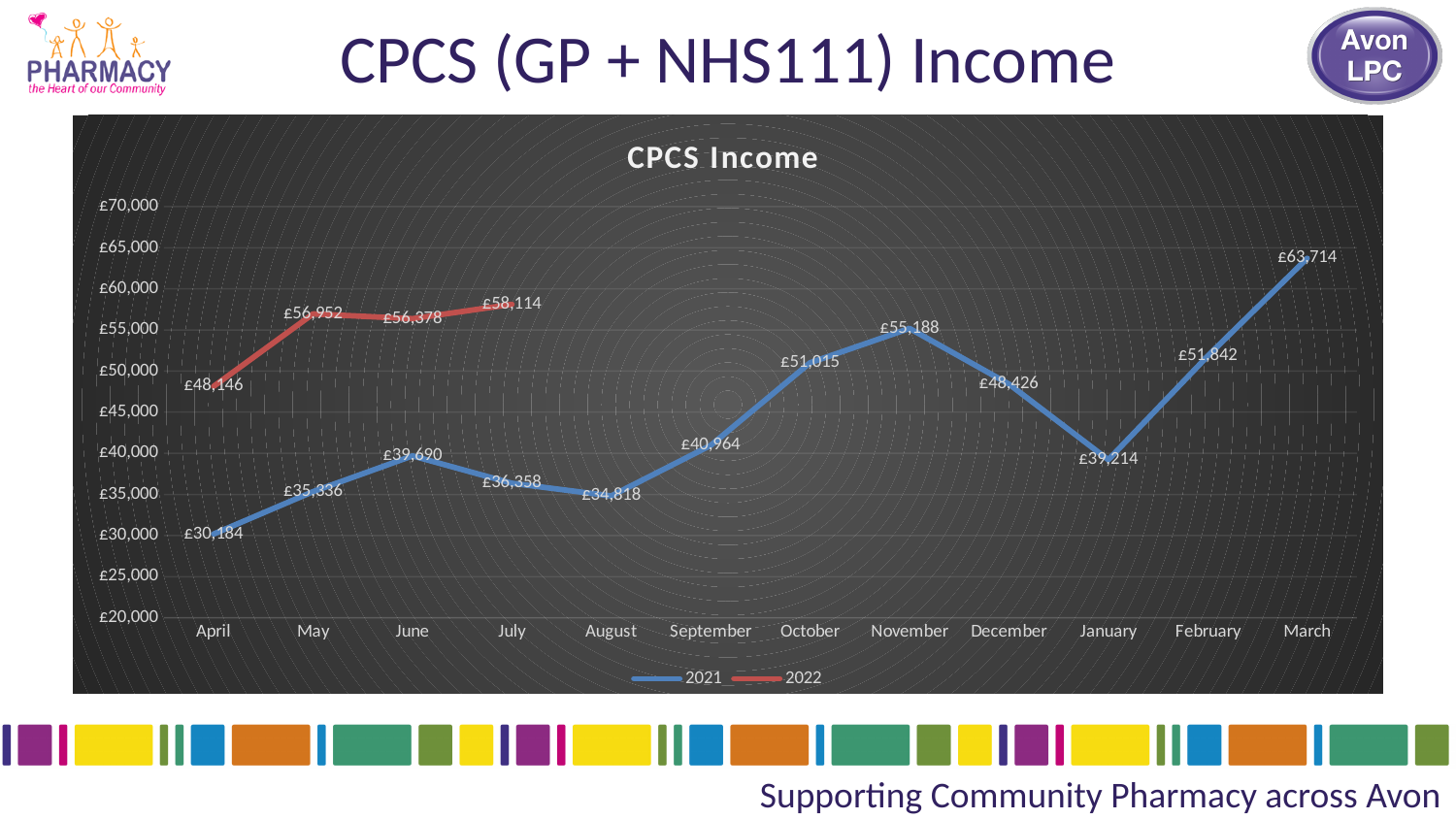
How many series does the legend list? 2 Which month has the highest 2021 CPCS income? March Which is larger, the 2021 CPCS income for October or for December? October What is the title of the chart? CPCS Income What is the 2021 CPCS income for April? £30,184 Which month has the lowest 2021 CPCS income? April What is the 2022 CPCS income for July? £58,114 What is the 2021 CPCS income for November? £55,188 What kind of chart is shown on the slide? line chart How many months are shown on the x axis? 12 Does the 2021 CPCS income rise or fall from January to March? rise What is the difference between the 2022 and 2021 CPCS income for April? £17,962